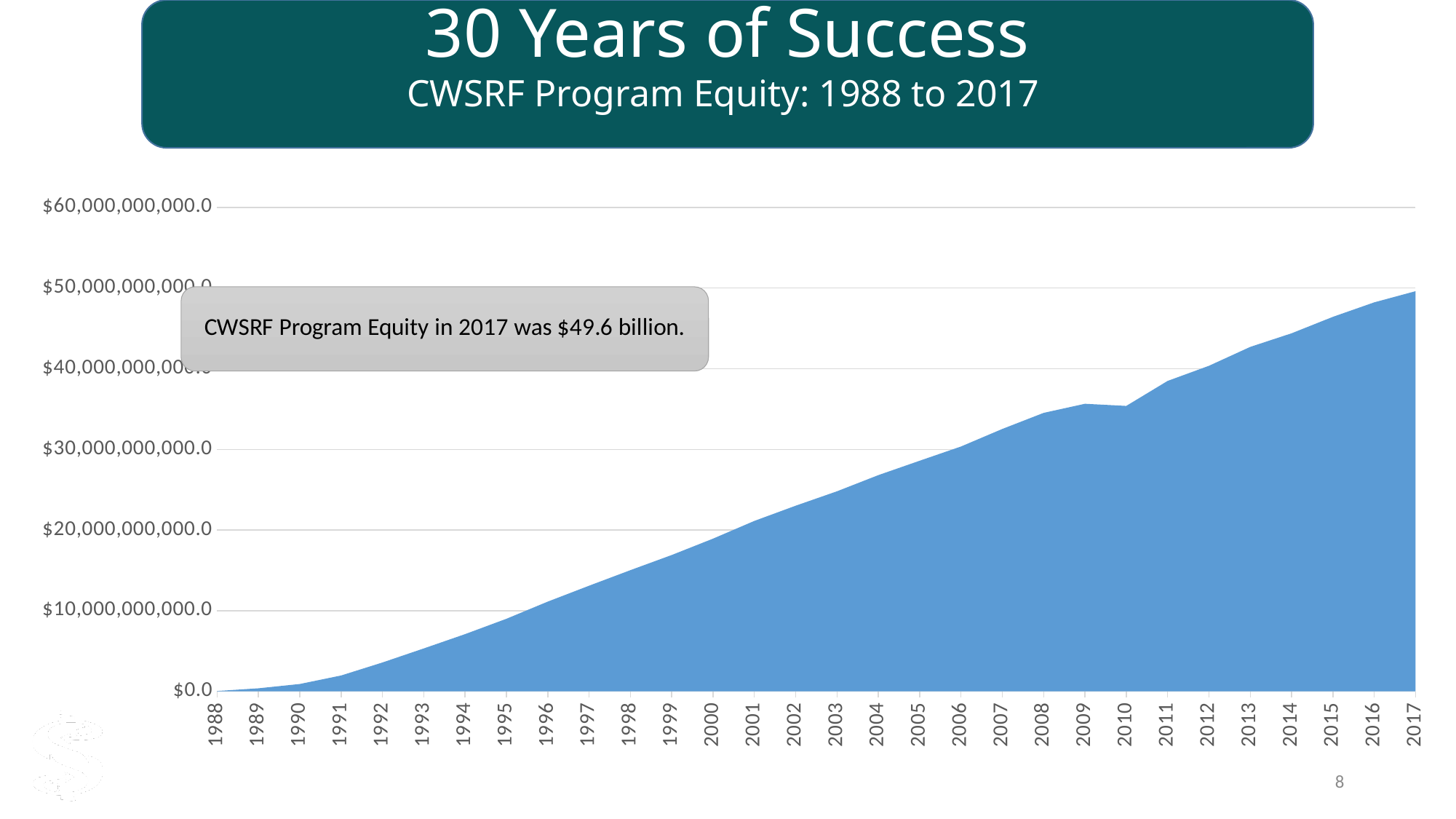
According to the callout on the chart, what was CWSRF Program Equity in 2017? $49.6 billion Does CWSRF Program Equity generally rise or fall from 1988 to 2017? Rise What kind of chart is shown on the slide? Area chart Is the value for 1994 greater or less than $10,000,000,000.0? less What is the subtitle of the chart shown under '30 Years of Success'? CWSRF Program Equity: 1988 to 2017 Which year has the highest CWSRF Program Equity? 2017 How many years are labelled on the x axis of the chart? 30 Is the value for 2008 greater or less than $30,000,000,000.0? greater Which year has the larger CWSRF Program Equity, 2005 or 2015? 2015 Is the value for 2013 greater or less than $40,000,000,000.0? greater What is the highest value labelled on the y axis of the chart? $60,000,000,000.0 Which year has the lowest CWSRF Program Equity? 1988